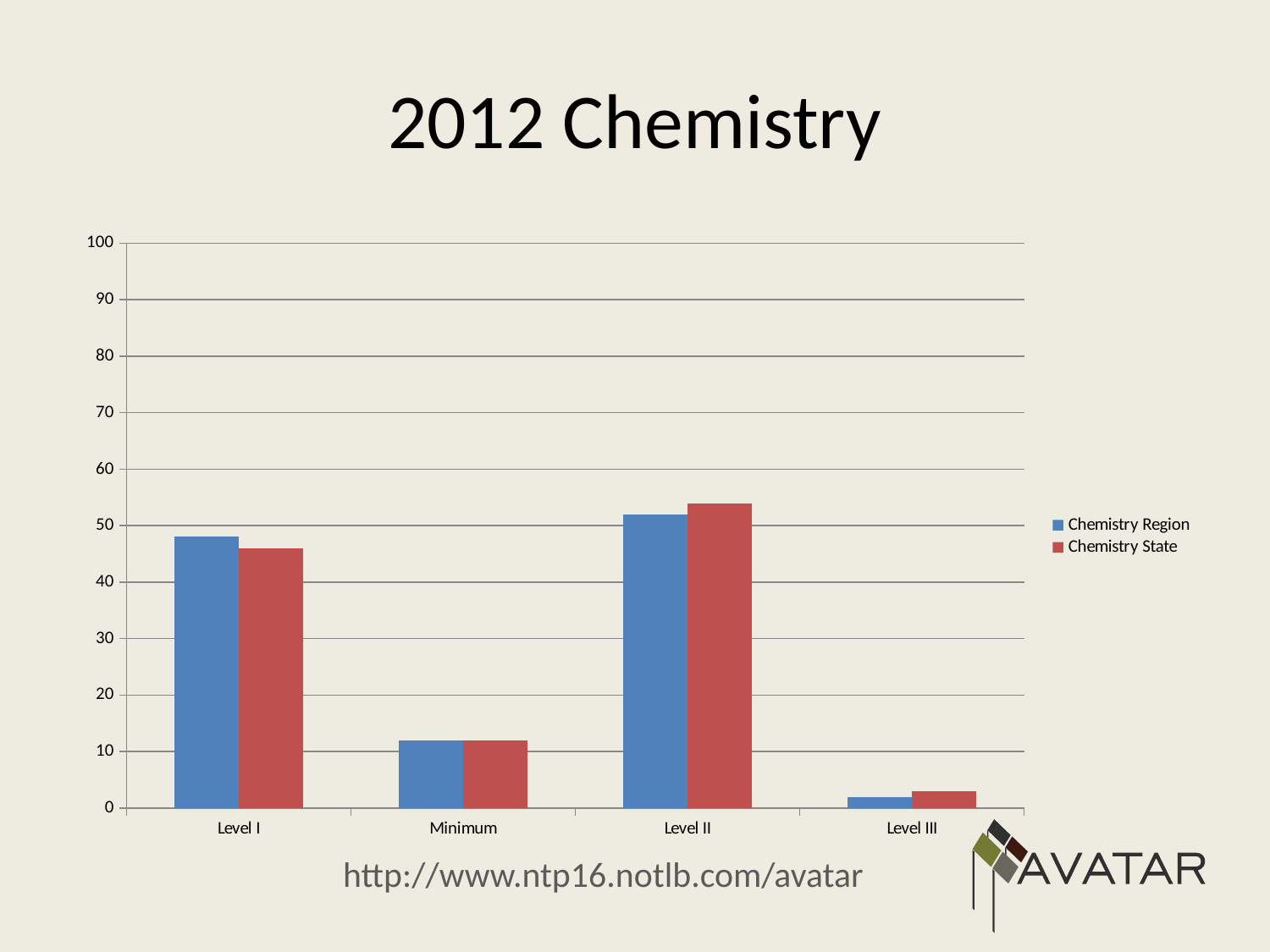
For Level II, which is larger: Chemistry Region or Chemistry State? Chemistry State How many series does the legend list? 2 What is the title of the chart? 2012 Chemistry Which category has the lowest value for Chemistry Region? Level III Which category has the lowest value for Chemistry State? Level III Is the Chemistry Region value for Level I greater or less than 40? greater How many categories are shown on the x axis? 4 Is the Chemistry Region value for Minimum greater or less than 20? less Is the Chemistry State value for Level II greater or less than 50? greater Which category has the highest value for Chemistry Region? Level II What kind of chart is shown on the slide? bar chart For Level I, which is larger: Chemistry Region or Chemistry State? Chemistry Region